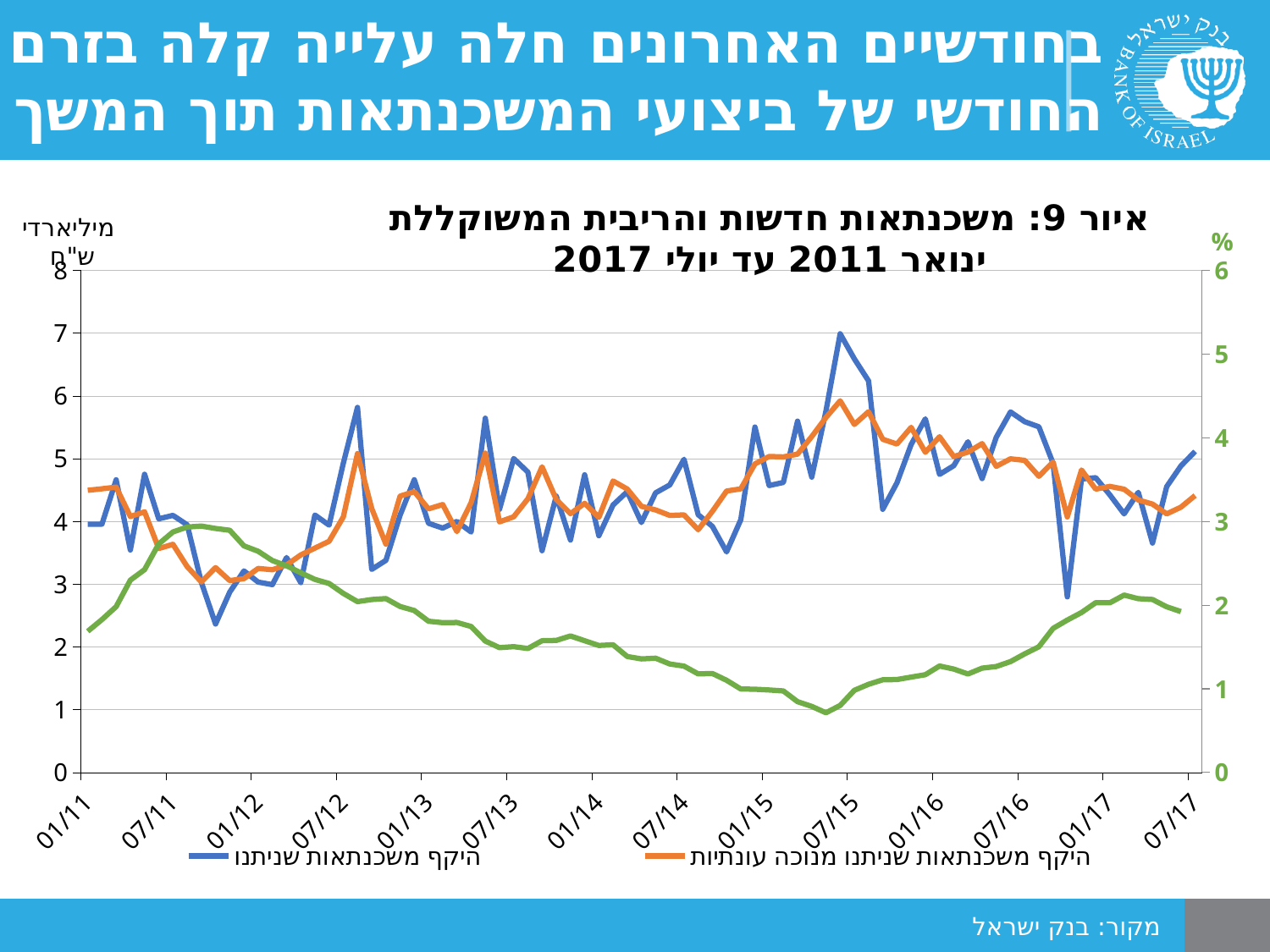
Is the value of the green line at its lowest point around 07/15 greater or less than 1 on the right axis? less What kind of chart is shown on the slide? line chart How many date labels are shown along the x axis? 14 Is the value of the blue line (היקף משכנתאות שניתנו) at its peak around 07/15 greater or less than 6 on the left axis? greater How many series does the legend list? 2 What is the title of the chart? איור 9: משכנתאות חדשות והריבית המשוקללת ינואר 2011 עד יולי 2017 What unit is shown on the left vertical axis? מיליארדי ש"ח Is the value of the blue line (היקף משכנתאות שניתנו) at 01/11 greater or less than 5 on the left axis? less Does the green line rise or fall between 01/14 and 07/15? fall Does the green line rise or fall between 07/15 and 01/17? rise At 07/15, which line is higher: the blue line (היקף משכנתאות שניתנו) or the orange line (היקף משכנתאות שניתנו מנוכה עונתיות)? the blue line (היקף משכנתאות שניתנו)